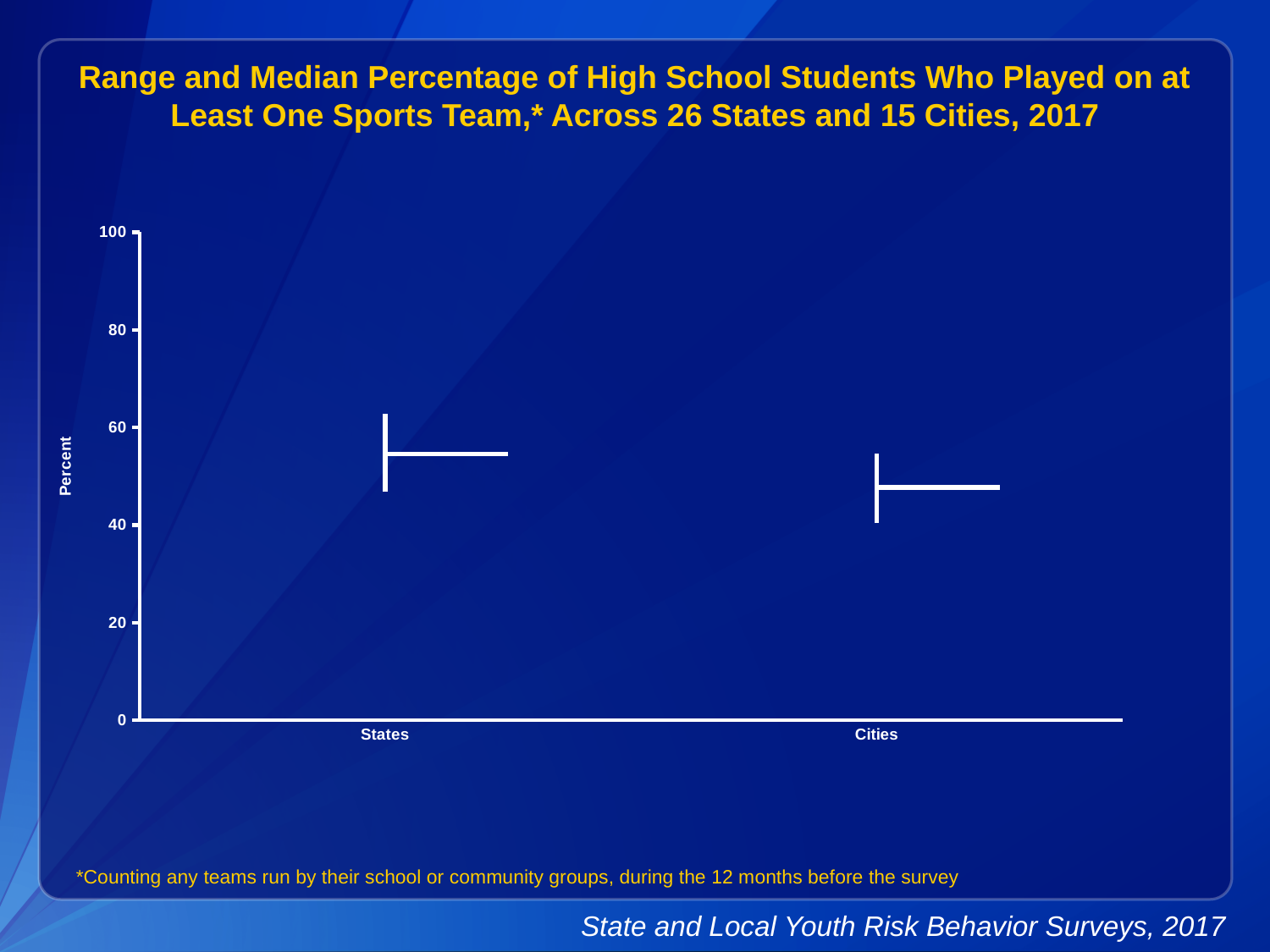
How many categories are shown on the x axis of the chart? 2 What are the two categories shown on the x axis? States and Cities Which category has the lowest median percentage? Cities Is the median value for States greater or less than 60? less Is the median value for States greater or less than 40? greater What is the label on the y axis of the chart? Percent What is the highest value shown on the y axis? 100 Which category has the higher median percentage, States or Cities? States Is the median value for Cities greater or less than 40? greater